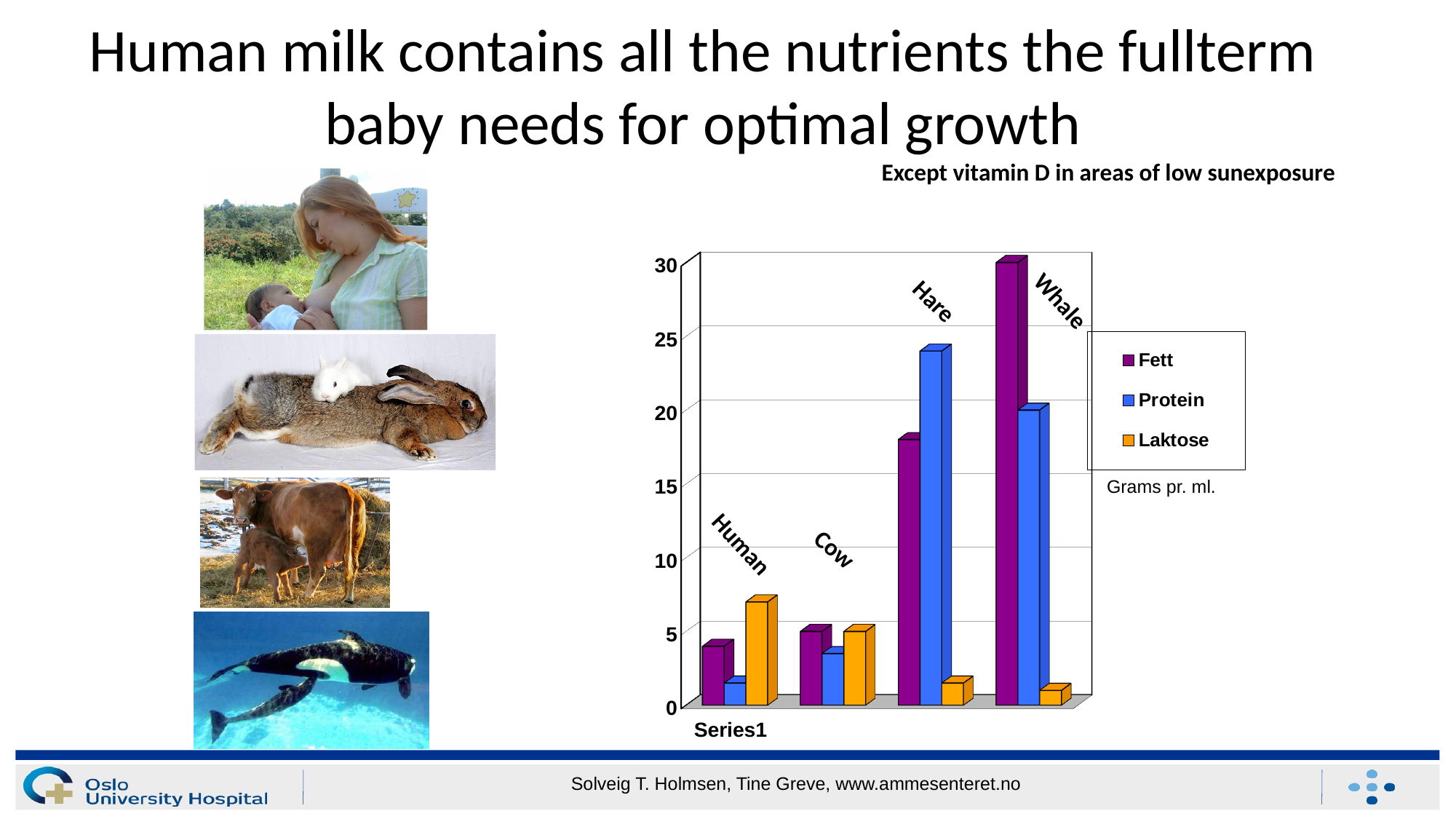
Is the Laktose value for Human greater or less than 5? greater Which animal has the highest Fett value? Whale What kind of chart is shown on the slide? bar chart How many animal groups are plotted in the chart? 4 Is the Laktose value for Whale greater or less than 5? less For Whale, which is larger: Fett or Protein? Fett Is the Protein value for Hare greater or less than 20? greater Which animal has the highest Laktose value? Human Which animal has the highest Protein value? Hare What unit label is shown next to the chart legend? Grams pr. ml. For Hare, which is larger: Fett or Protein? Protein How many series does the chart legend list? 3